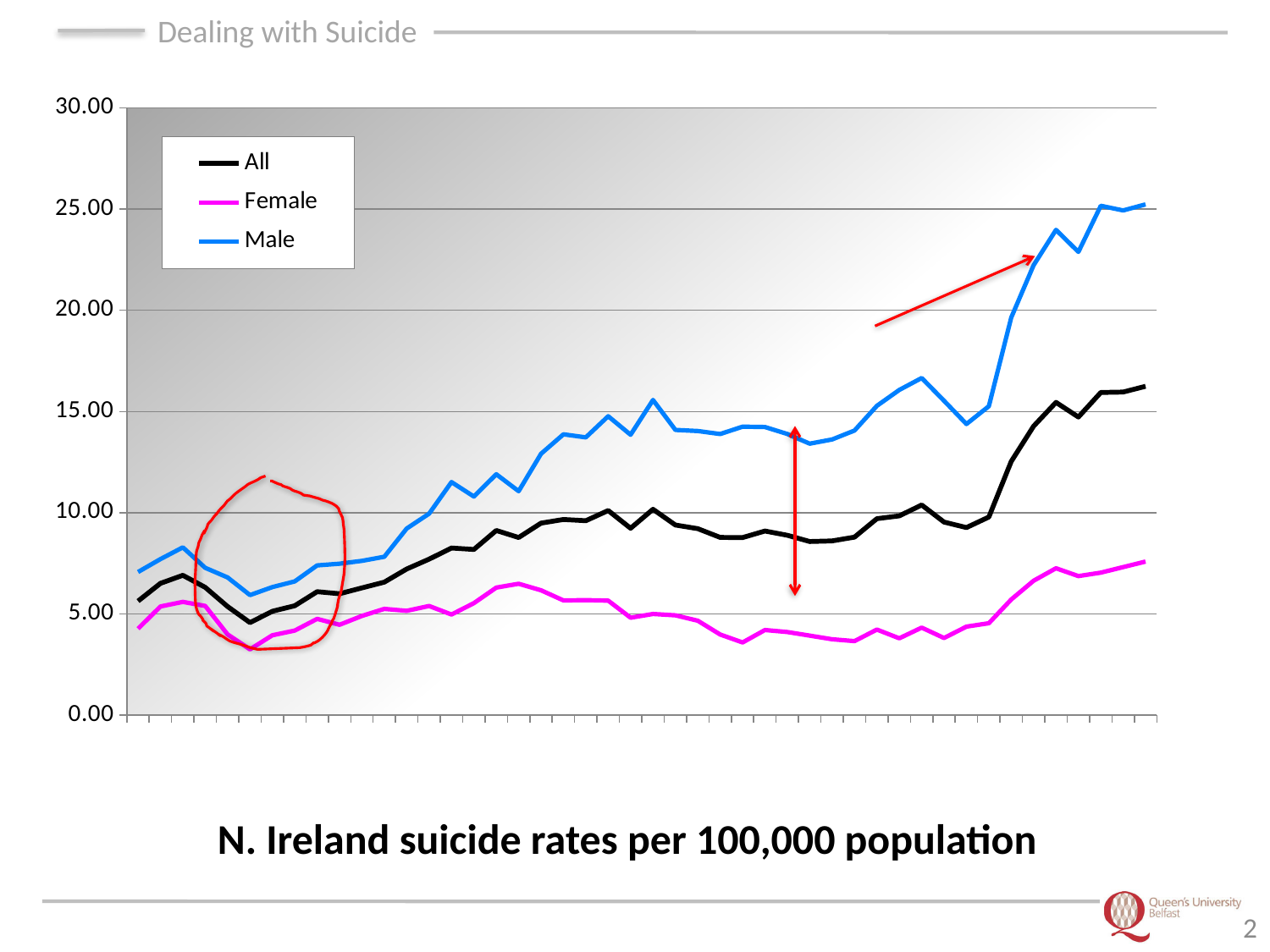
Does the Male series overall rise or fall from left to right across the chart? Rise At the right-hand end of the chart, is the Female value greater or less than 10.00? less Which series does the legend show in blue? Male Which series has the lowest value at the right-hand end of the chart? Female Does the Female series ever exceed 10.00 on the chart? No At the right-hand end of the chart, which is larger, the Male value or the Female value? Male Which series has the highest value at the right-hand end of the chart? Male At the right-hand end of the chart, is the All value greater or less than 15.00? greater How many series does the legend list? 3 What is the caption below the chart? N. Ireland suicide rates per 100,000 population What kind of chart is shown on the slide? Line chart